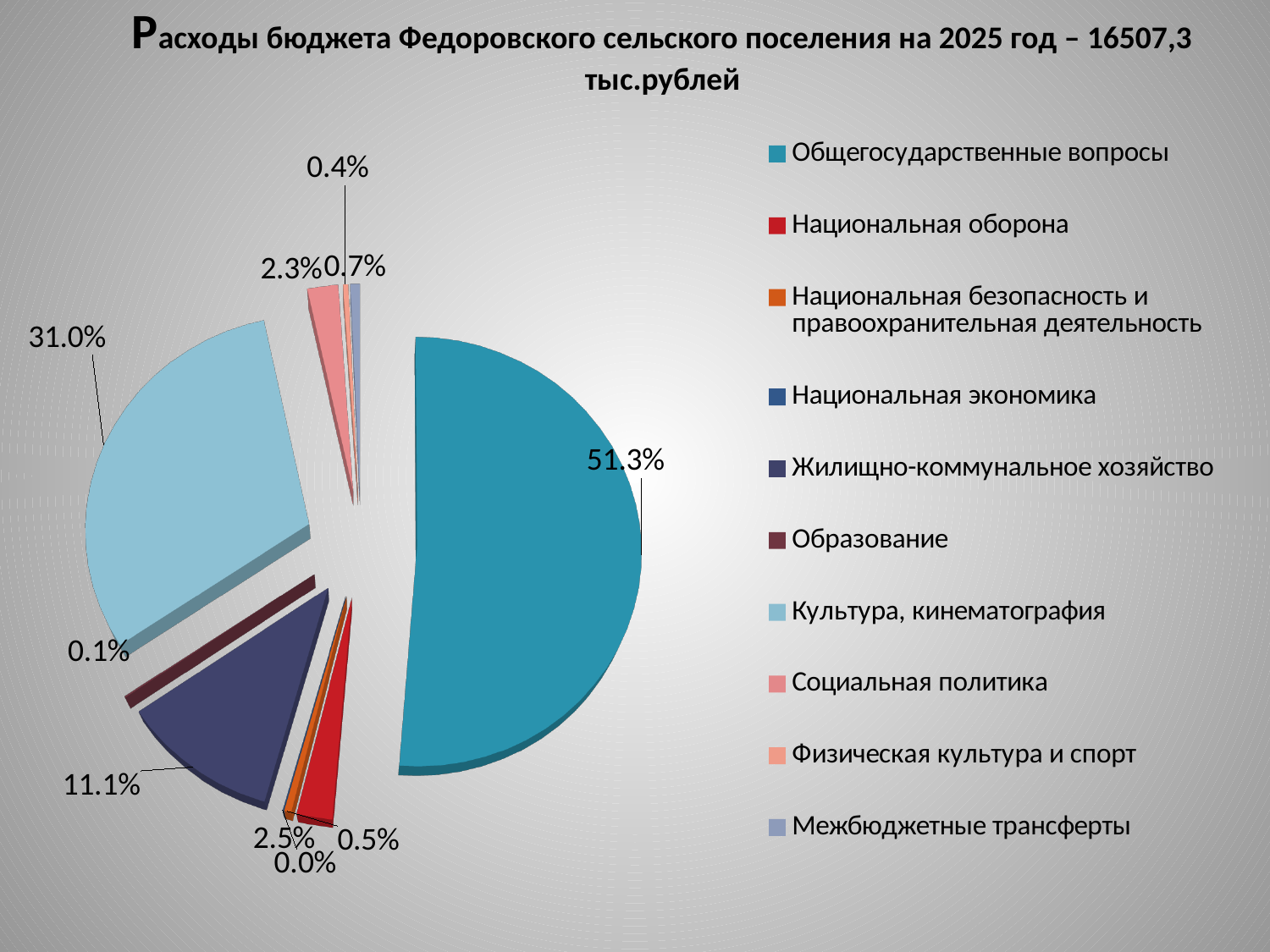
Which category has the largest share of the pie? Общегосударственные вопросы What share of the budget goes to Общегосударственные вопросы? 51.3% Which is larger: the share for Культура, кинематография or the share for Жилищно-коммунальное хозяйство? Культура, кинематография According to the chart title, what is the total budget expenditure for 2025? 16507,3 тыс.рублей By how many percentage points does the share for Жилищно-коммунальное хозяйство exceed the share for Социальная политика? 8.8 percentage points What share of the budget goes to Жилищно-коммунальное хозяйство? 11.1% What share of the budget goes to Образование? 0.1% By how many percentage points does the share for Общегосударственные вопросы exceed the share for Культура, кинематография? 20.3 percentage points How many categories does the legend of the pie chart list? 10 What share of the budget goes to Социальная политика? 2.3% What share of the budget goes to Культура, кинематография? 31.0% What kind of chart is shown on the slide? pie chart